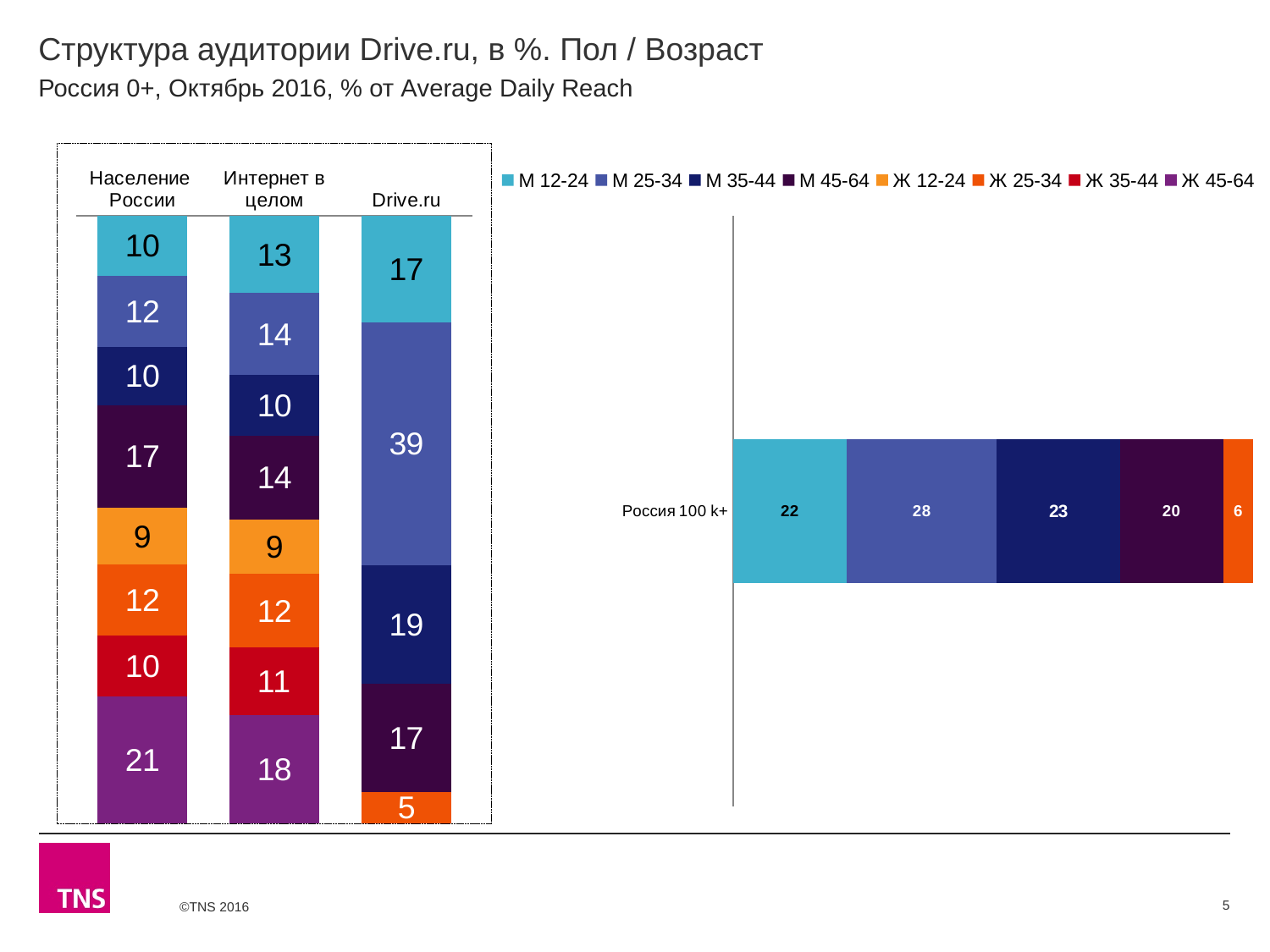
In the left chart, what is the value of the М 12-24 segment for Интернет в целом? 13 In the right chart, what is the value of the М 25-34 segment for Россия 100 k+? 28 In the right chart, which segment of the Россия 100 k+ bar is the smallest? Ж 25-34 In the left chart, what is the value of the М 25-34 segment for Drive.ru? 39 In the left chart, what is the difference between the М 25-34 values for Drive.ru and Население России? 27 In the left chart, which is larger: the Ж 45-64 value for Население России or for Интернет в целом? Население России In the left chart, how many bars are shown? 3 What kind of chart is shown on the right side of the slide? Stacked horizontal bar chart In the left chart, what is the value of the Ж 45-64 segment for Население России? 21 How many series does the legend list? 8 In the right chart, what is the difference between the М 25-34 and М 45-64 segments for Россия 100 k+? 8 In the left chart, which segment of the Drive.ru bar is the largest? М 25-34